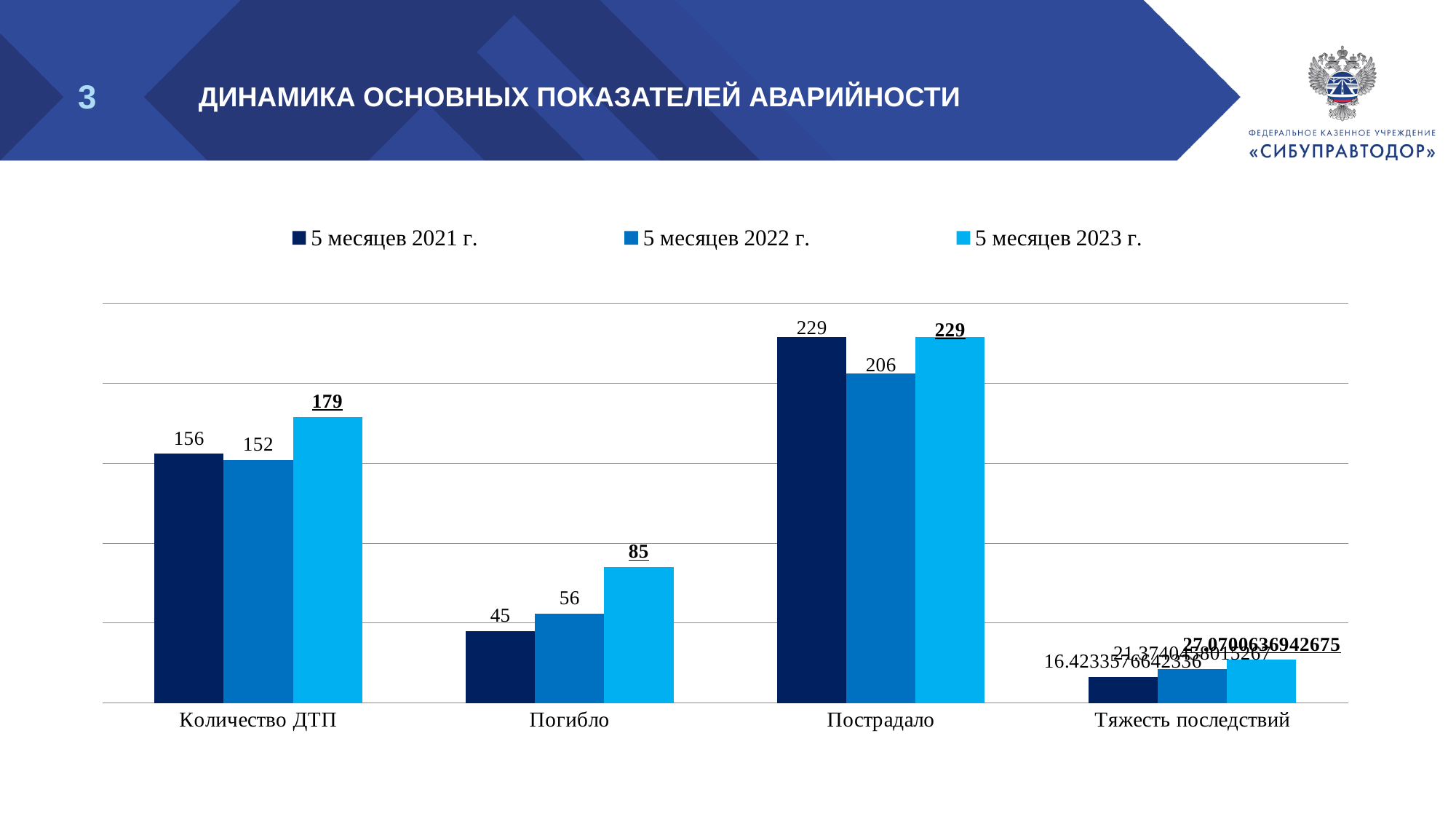
What is the value for Погибло in the series 5 месяцев 2021 г.? 45 What is the value for Пострадало in the series 5 месяцев 2022 г.? 206 How many series does the legend list? 3 What is the title of the slide containing the chart? ДИНАМИКА ОСНОВНЫХ ПОКАЗАТЕЛЕЙ АВАРИЙНОСТИ Which is larger for Количество ДТП: the value for 5 месяцев 2021 г. or for 5 месяцев 2022 г.? 5 месяцев 2021 г. How many categories are shown on the x axis? 4 Do the values for Погибло rise or fall from 5 месяцев 2021 г. to 5 месяцев 2023 г.? rise What is the value for Количество ДТП in the series 5 месяцев 2023 г.? 179 Which category has the highest value in the series 5 месяцев 2023 г.? Пострадало What kind of chart is shown on the slide? bar chart What is the value for Количество ДТП in the series 5 месяцев 2022 г.? 152 What is the difference between the 5 месяцев 2023 г. and 5 месяцев 2022 г. values for Погибло? 29